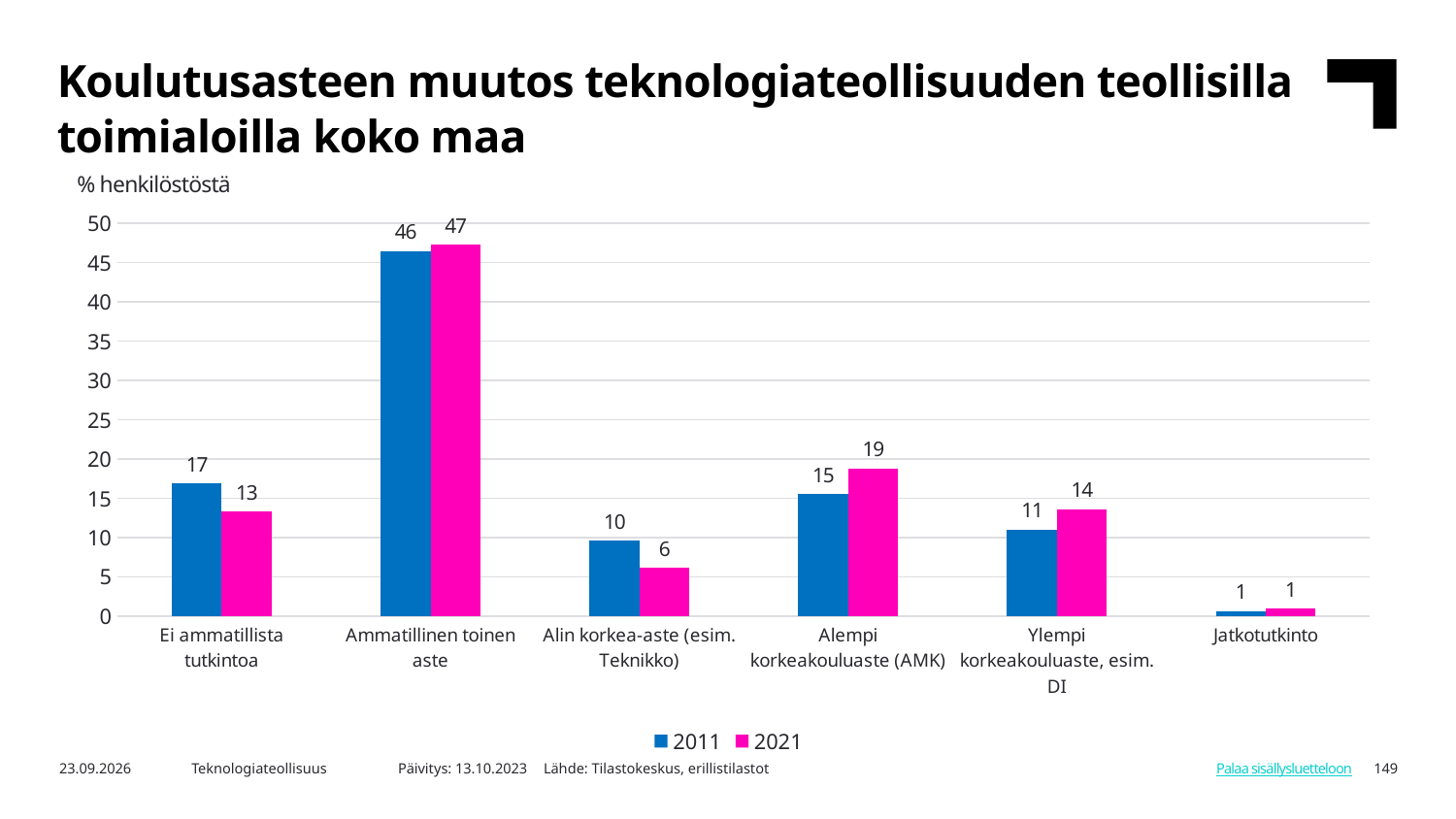
What is the 2021 value for Ammatillinen toinen aste? 47 Which category has the highest 2021 value? Ammatillinen toinen aste How many series does the legend list? 2 Which colour represents the 2021 series? Magenta (pink) What is the 2011 value for Ylempi korkeakouluaste, esim. DI? 11 Which category has the lowest 2011 value? Jatkotutkinto What is the 2021 value for Alin korkea-aste (esim. Teknikko)? 6 What kind of chart is shown on the slide? Bar chart How many education categories are shown on the x axis? 6 What is the 2011 value for Ei ammatillista tutkintoa? 17 For Ei ammatillista tutkintoa, which year has the larger value, 2011 or 2021? 2011 What is the difference between the 2021 and 2011 values for Alempi korkeakouluaste (AMK)? 4